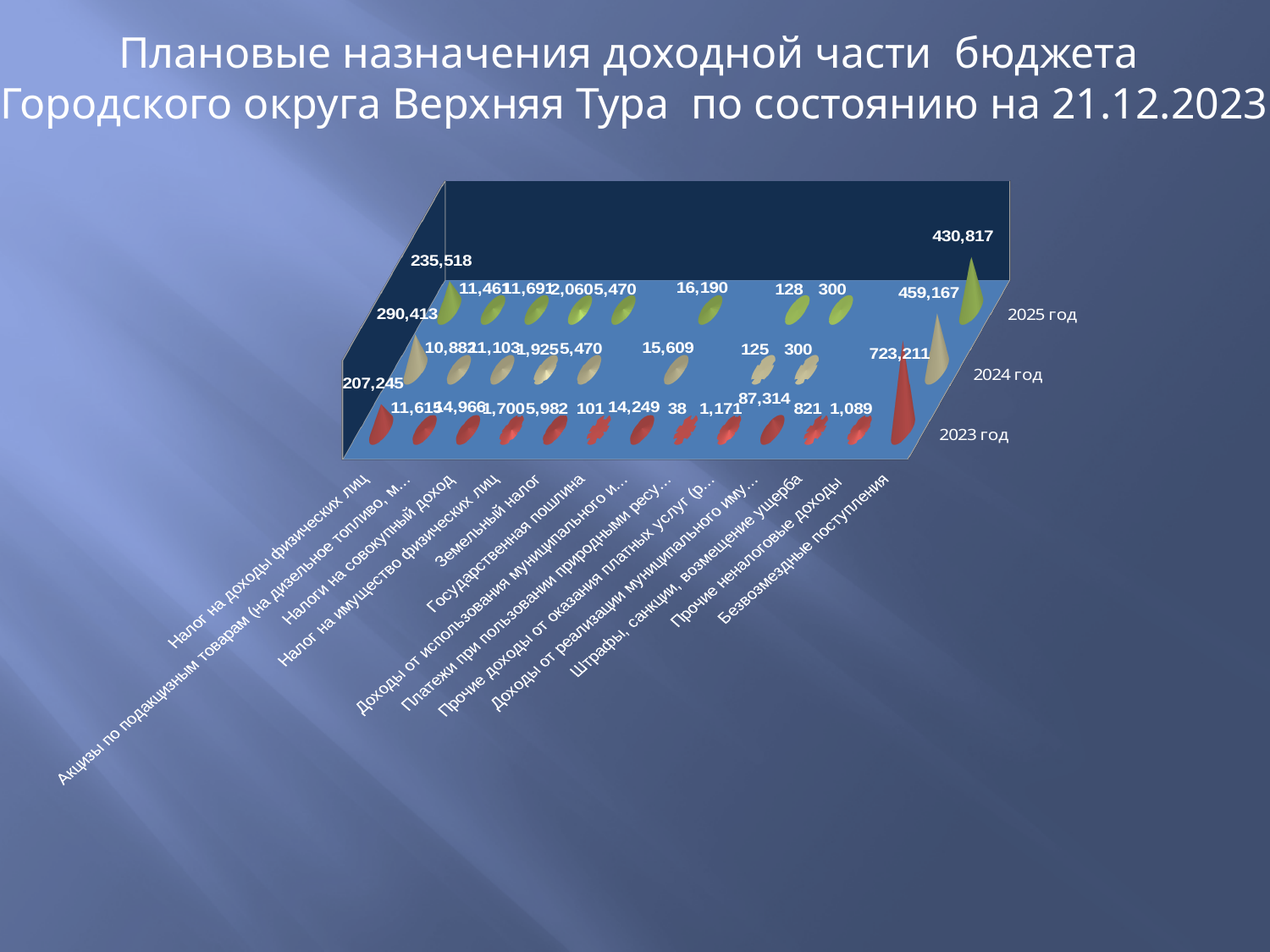
Which is larger for Безвозмездные поступления: the 2023 год value or the 2024 год value? 2023 год Which years are listed as the series of the chart? 2023 год, 2024 год, 2025 год Which category has the highest value in 2023 год? Безвозмездные поступления Which category has the lowest value in 2023 год? Платежи при пользовании природными ресурсами How many revenue categories are plotted along the x axis? 13 How many series does the chart show (years)? 3 What is the value for Налог на доходы физических лиц in 2024 год? 290,413 What is the value for Безвозмездные поступления in 2023 год? 723,211 What is the value for Безвозмездные поступления in 2025 год? 430,817 What is the difference between the 2024 год and 2023 год values for Налог на доходы физических лиц? 83,168 What is the value for Безвозмездные поступления in 2024 год? 459,167 What kind of chart is shown on the slide? bar chart